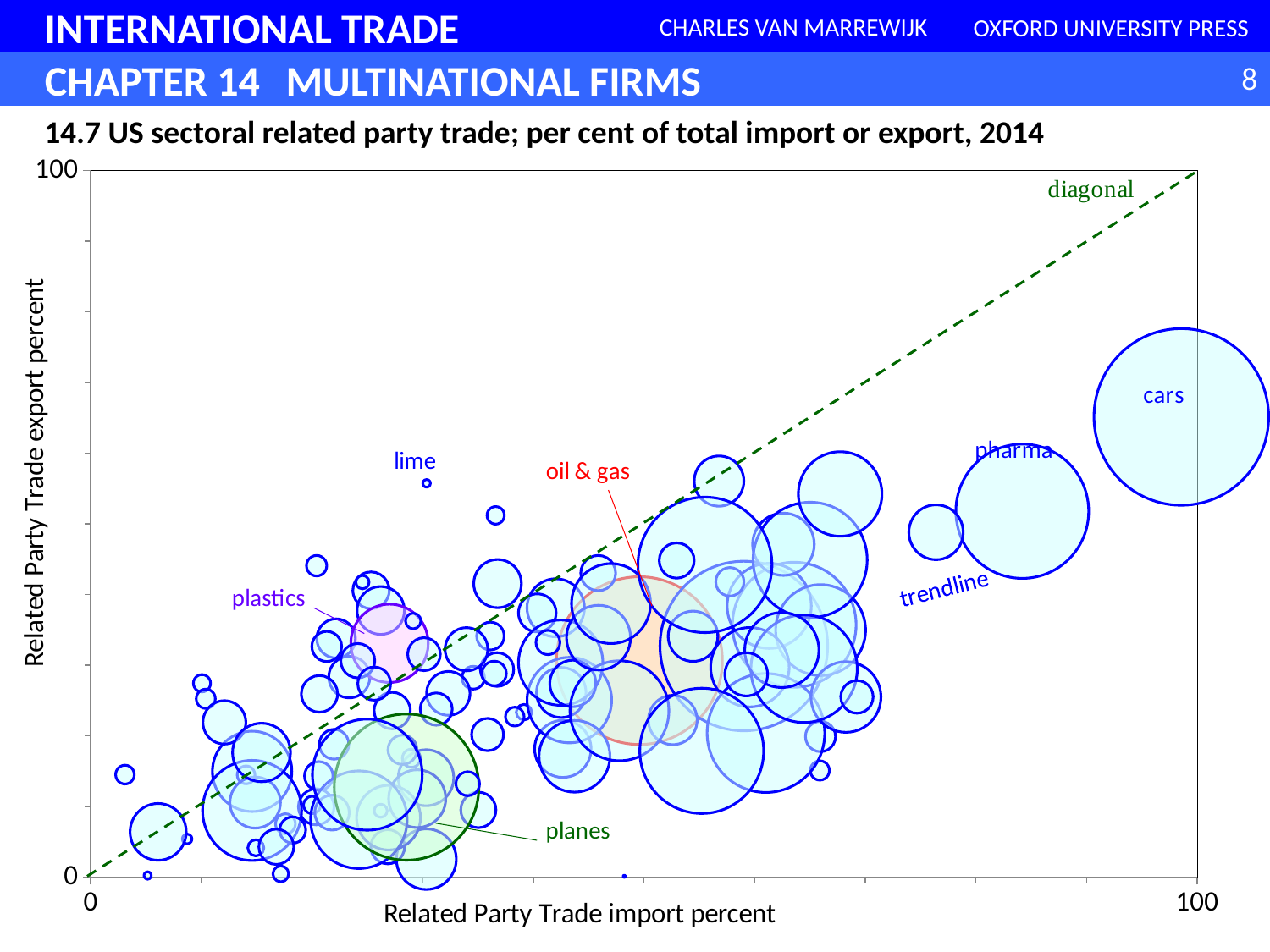
Which labelled sector has the highest Related Party Trade import percent? cars Which labelled sector has the largest bubble in the chart? cars Which labelled sector has the lowest Related Party Trade export percent? planes Which has a higher Related Party Trade import percent, cars or plastics? cars Which has a higher Related Party Trade import percent, pharma or plastics? pharma How many sectors are labelled by name on the chart? 6 Which has a higher Related Party Trade export percent, lime or planes? lime What is the title of the chart? 14.7 US sectoral related party trade; per cent of total import or export, 2014 What is the label of the dashed green line in the chart? diagonal What kind of chart is shown on the slide? bubble chart Which labelled sector has the highest Related Party Trade export percent? cars